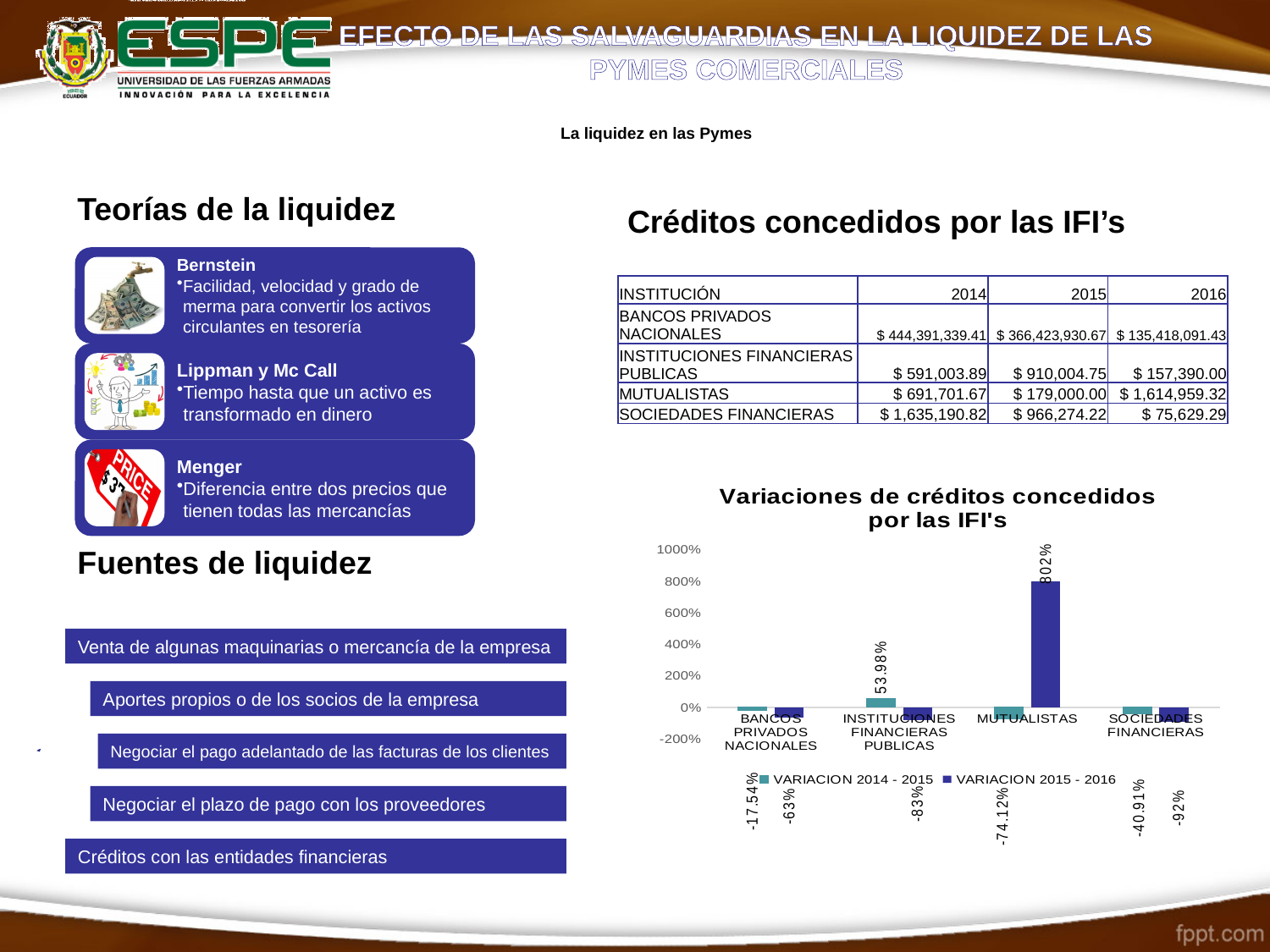
In the 'Variaciones de créditos concedidos por las IFI's' chart, which category has the lowest VARIACION 2014 - 2015 value? MUTUALISTAS How many institution categories are shown on the x axis of the 'Variaciones de créditos concedidos por las IFI's' chart? 4 In the 'Variaciones de créditos concedidos por las IFI's' chart, which is larger for SOCIEDADES FINANCIERAS: the VARIACION 2014 - 2015 value or the VARIACION 2015 - 2016 value? VARIACION 2014 - 2015 In the 'Variaciones de créditos concedidos por las IFI's' chart, which category has the highest VARIACION 2015 - 2016 value? MUTUALISTAS In the 'Variaciones de créditos concedidos por las IFI's' chart, is the VARIACION 2015 - 2016 value for MUTUALISTAS greater or less than 600%? greater What type of chart is 'Variaciones de créditos concedidos por las IFI's'? bar chart How many series does the legend of the 'Variaciones de créditos concedidos por las IFI's' chart list? 2 In the 'Variaciones de créditos concedidos por las IFI's' chart, what is the VARIACION 2015 - 2016 value for SOCIEDADES FINANCIERAS? -92% In the 'Variaciones de créditos concedidos por las IFI's' chart, what is the VARIACION 2014 - 2015 value for INSTITUCIONES FINANCIERAS PUBLICAS? 53.98% In the 'Variaciones de créditos concedidos por las IFI's' chart, what is the VARIACION 2014 - 2015 value for MUTUALISTAS? -74.12% In the 'Variaciones de créditos concedidos por las IFI's' chart, what is the VARIACION 2014 - 2015 value for BANCOS PRIVADOS NACIONALES? -17.54% In the 'Variaciones de créditos concedidos por las IFI's' chart, what is the VARIACION 2015 - 2016 value for MUTUALISTAS? 802%